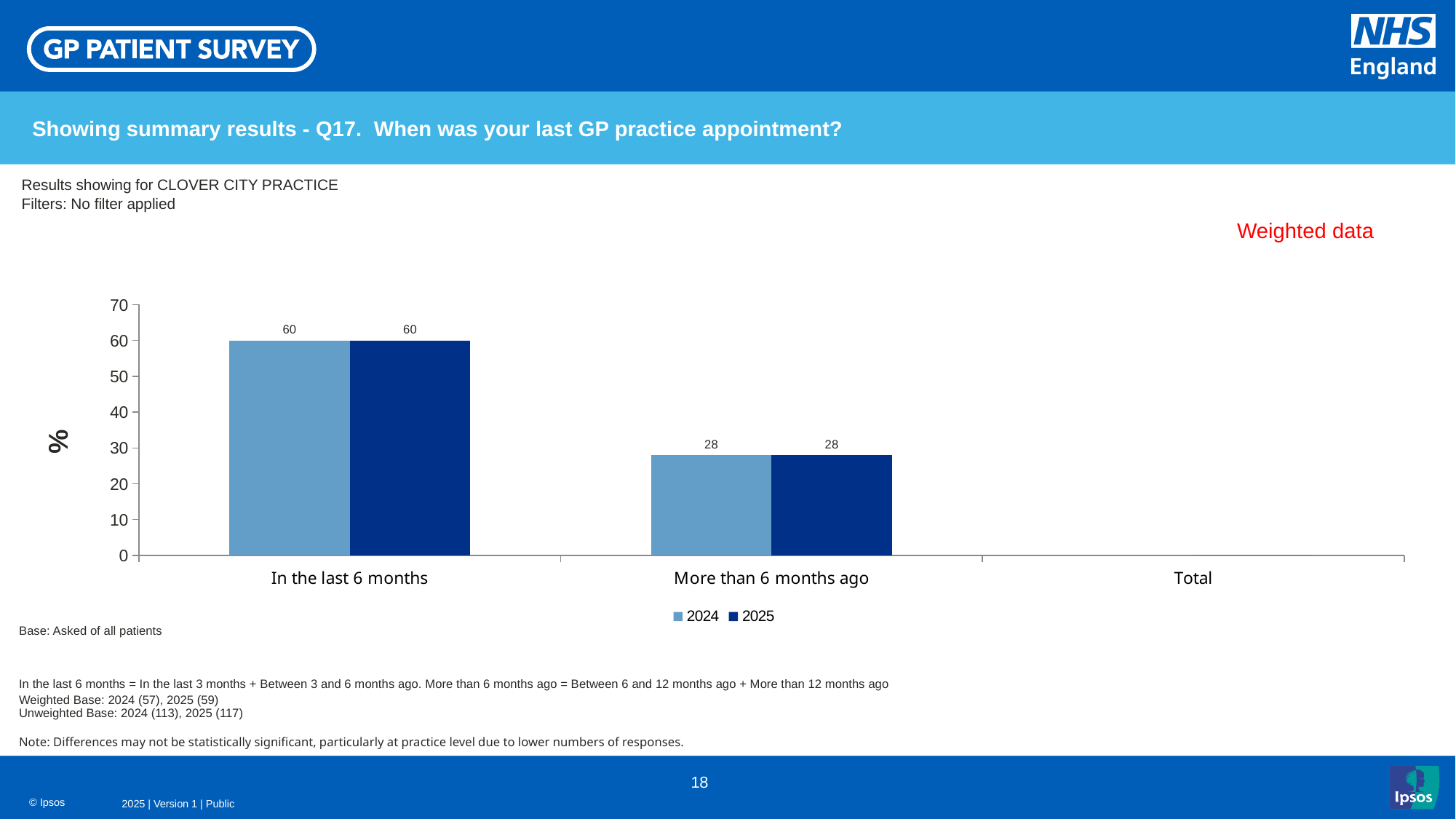
How many series does the legend list? 2 Is the 2024 value for "More than 6 months ago" greater or less than 30? less What is the value for 2024 in the "In the last 6 months" category? 60 What is the value for 2025 in the "In the last 6 months" category? 60 What label is shown on the y axis of the chart? % What is the difference between the 2024 values for "In the last 6 months" and "More than 6 months ago"? 32 How many category labels are shown on the x axis? 3 What is the value for 2025 in the "More than 6 months ago" category? 28 Which is larger for 2025: "In the last 6 months" or "More than 6 months ago"? In the last 6 months What kind of chart is shown on the slide? Bar chart What is the value for 2024 in the "More than 6 months ago" category? 28 Which category has the highest value for 2025? In the last 6 months